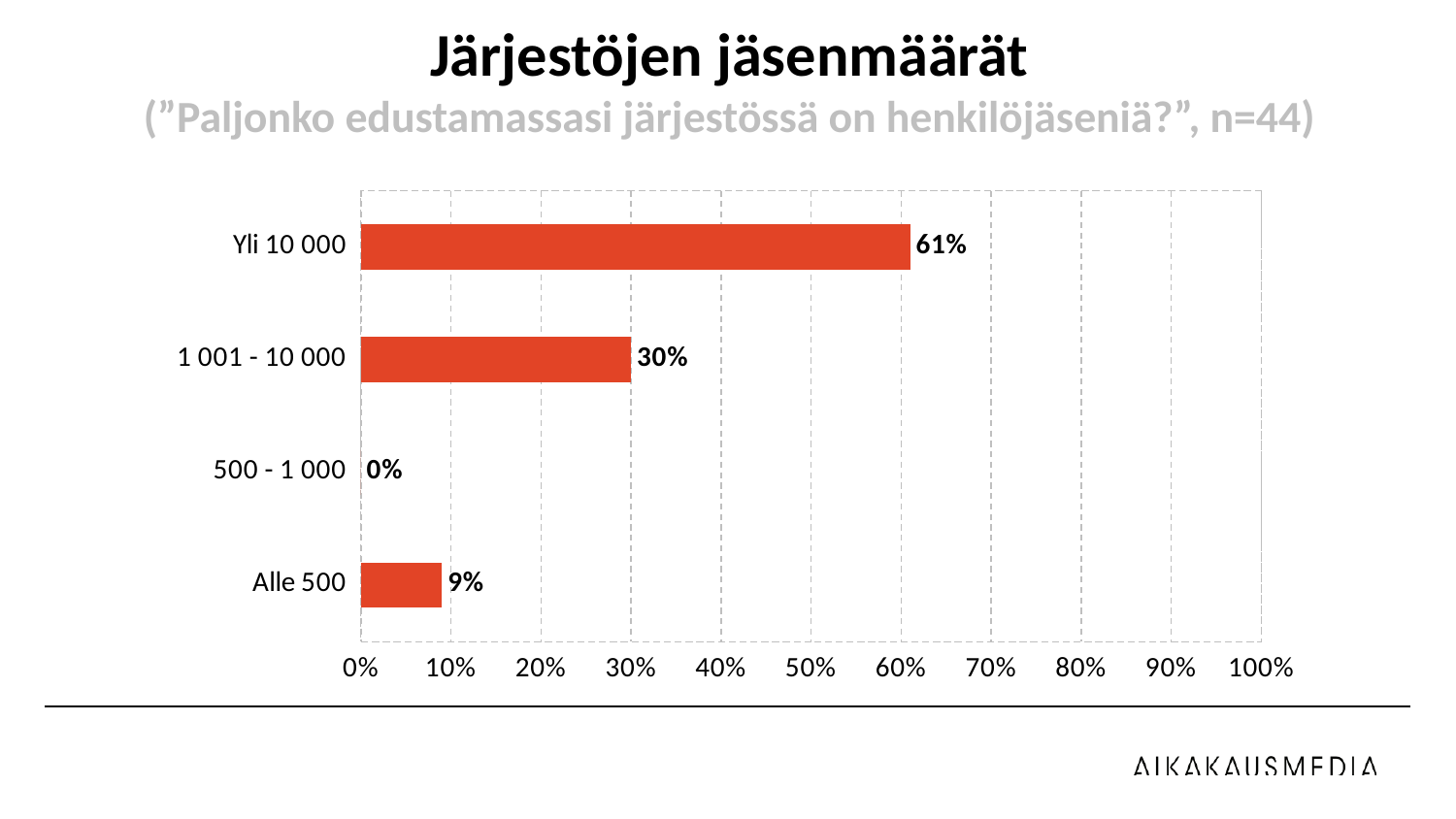
What is the value for "1 001 - 10 000"? 30% How many categories are shown in the chart? 4 What is the title of the chart? Järjestöjen jäsenmäärät What is the difference between the values for "Yli 10 000" and "1 001 - 10 000"? 31% What is the value for "Alle 500"? 9% What is the value for "Yli 10 000"? 61% What kind of chart is shown on the slide? bar chart What is the value for "500 - 1 000"? 0% Is the value for "Yli 10 000" greater or less than 50%? greater Which category has the highest value? Yli 10 000 Which is larger, the value for "Alle 500" or the value for "1 001 - 10 000"? 1 001 - 10 000 Which category has the lowest value? 500 - 1 000